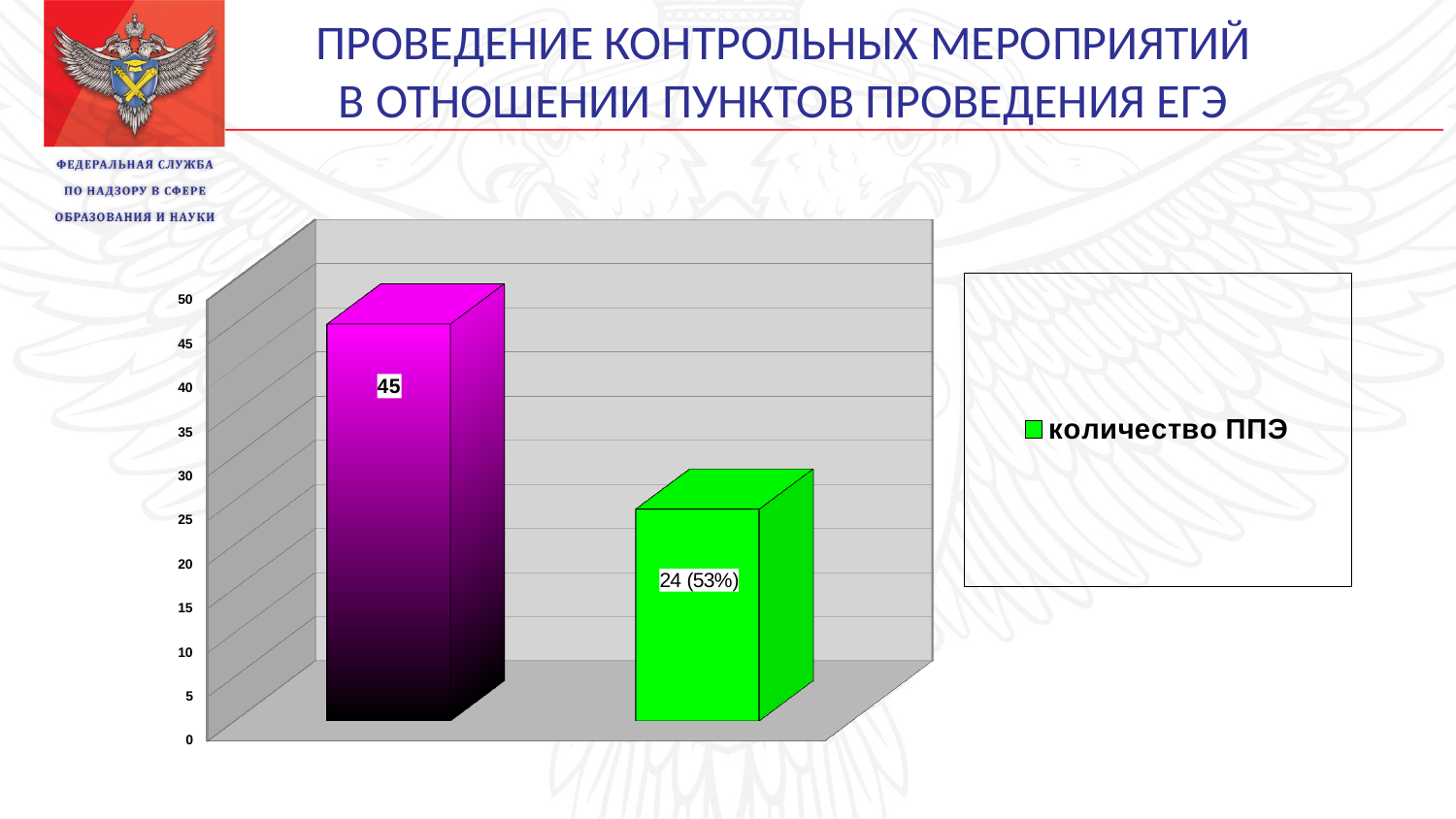
What value is printed on the magenta (left) bar? 45 Is the value of the magenta bar greater or less than 40? greater Which bar is the shortest, the magenta one or the green one? the green (right) bar What label is printed on the green (right) bar? 24 (53%) What is the difference between the value of the magenta bar (45) and the value of the green bar (24)? 21 Is the value of the green bar larger or smaller than the value of the magenta bar? smaller What kind of chart is shown on the slide? bar chart Which bar is the tallest, the magenta one or the green one? the magenta (left) bar Is the value of the green bar greater or less than 30? less What is the legend entry shown next to the chart? количество ППЭ How many bars are plotted in the chart? 2 How many series does the legend list? 1